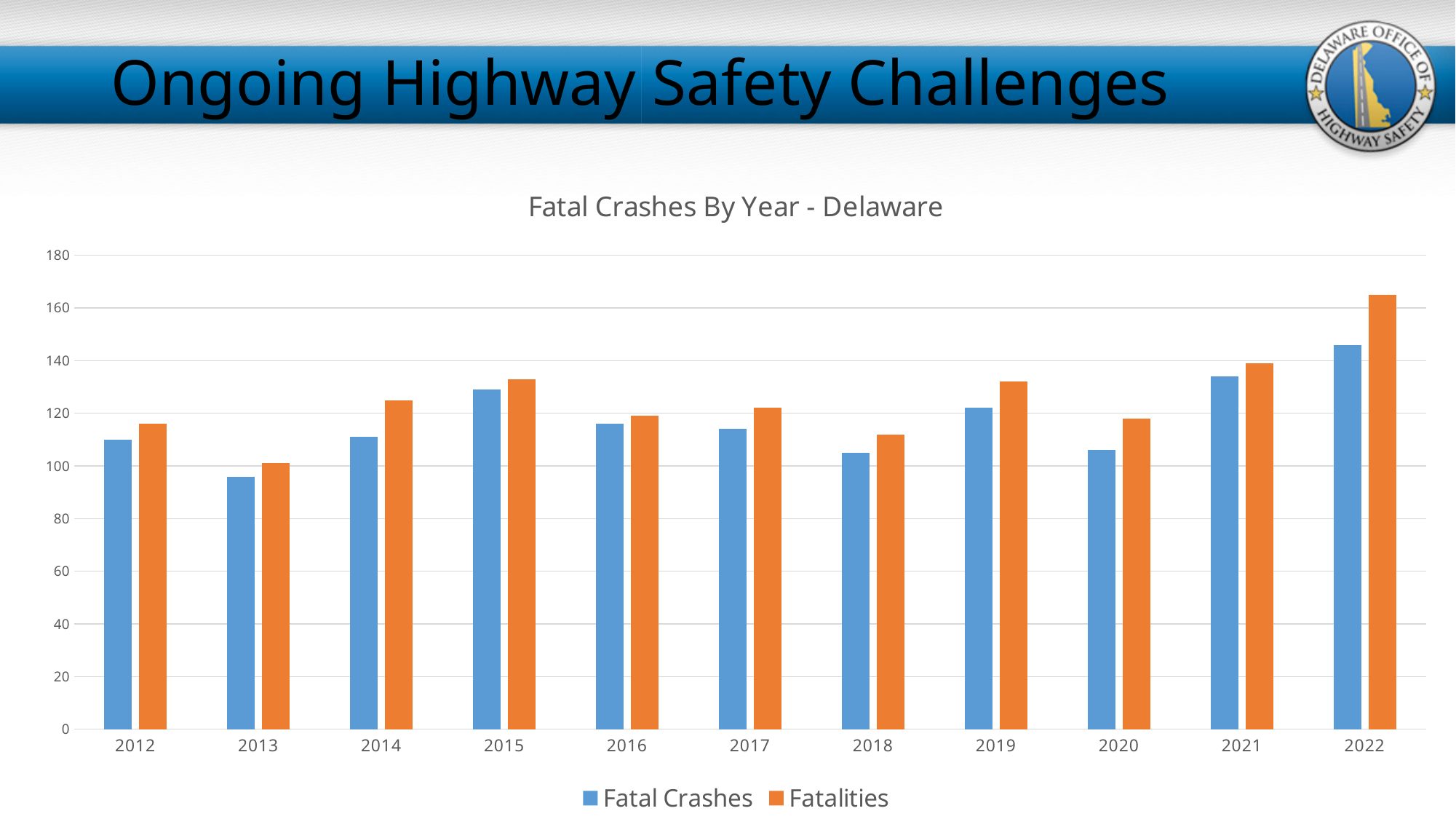
What is the title of the chart? Fatal Crashes By Year - Delaware Is the Fatalities value for 2022 greater or less than 160? greater What kind of chart is shown on the slide? bar chart How many years are shown on the x axis? 11 Is the Fatal Crashes value for 2015 greater or less than 120? greater Which year has more Fatal Crashes, 2015 or 2018? 2015 Is the Fatalities value for 2014 greater or less than 120? greater Do the Fatalities values rise or fall from 2020 to 2022? rise Which year has the lowest number of Fatal Crashes? 2013 Which year has the highest number of Fatalities? 2022 How many series does the legend list? 2